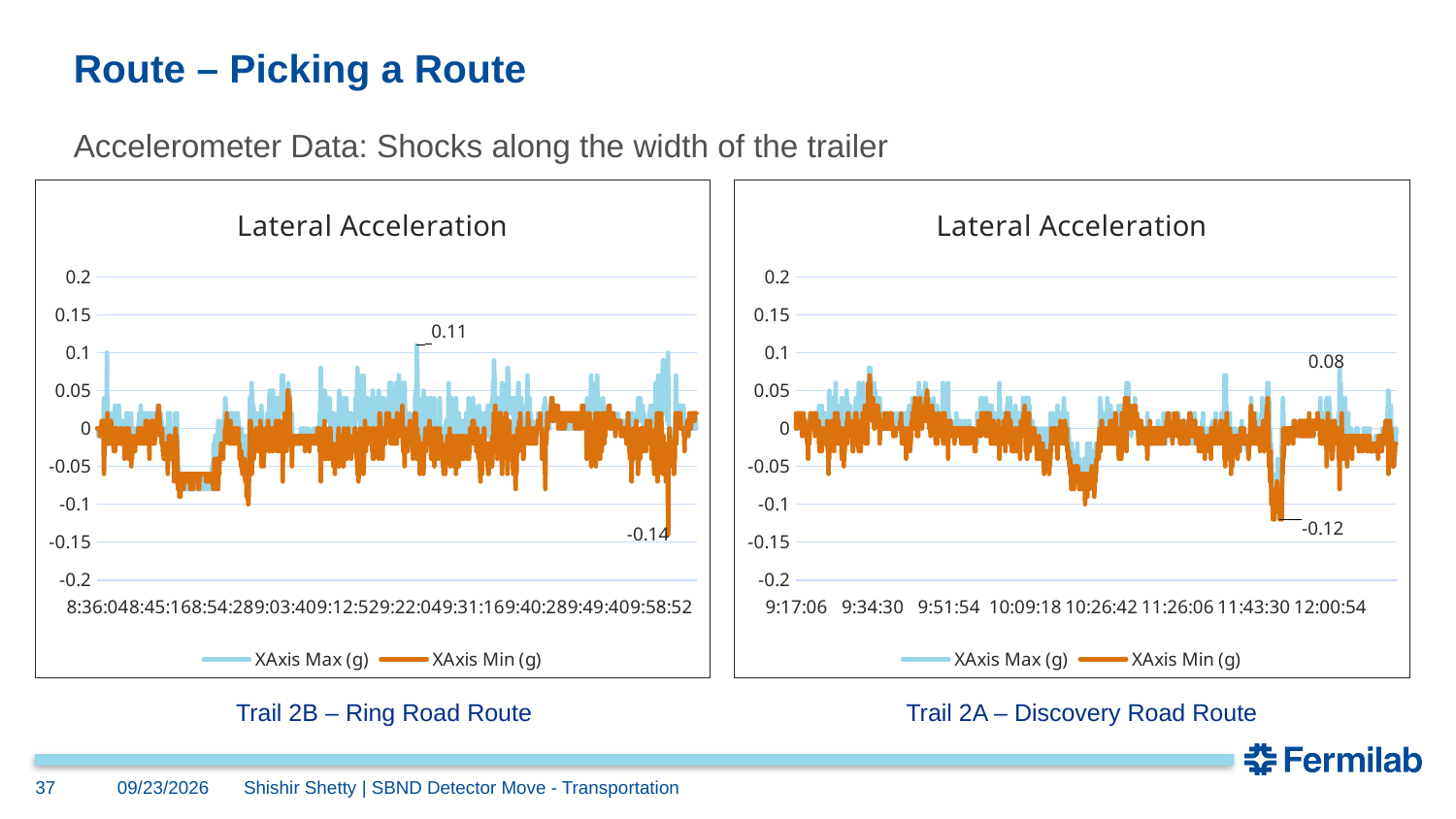
In the right chart (Trail 2A – Discovery Road Route), what is the labelled lowest value of the XAxis Min (g) series? -0.12 In the right chart (Trail 2A – Discovery Road Route), what is the labelled peak value of the XAxis Max (g) series? 0.08 What is the difference between the labelled minimum values of the left chart (-0.14) and the right chart (-0.12)? 0.02 What is the title of both charts on the slide? Lateral Acceleration How many series does the legend of the left chart (Trail 2B – Ring Road Route) list? 2 What kind of chart is the right chart (Trail 2A – Discovery Road Route)? Line chart In the left chart (Trail 2B – Ring Road Route), is the lowest value of the XAxis Min (g) series greater or less than -0.1? less Which route has the larger labelled peak lateral acceleration, Trail 2B – Ring Road Route or Trail 2A – Discovery Road Route? Trail 2B – Ring Road Route What is the difference between the labelled peak values of the left chart (0.11) and the right chart (0.08)? 0.03 In the right chart (Trail 2A – Discovery Road Route), is the highest value of the XAxis Max (g) series greater or less than 0.1? less In the left chart (Trail 2B – Ring Road Route), what is the labelled lowest value of the XAxis Min (g) series? -0.14 In the left chart (Trail 2B – Ring Road Route), what is the labelled peak value of the XAxis Max (g) series? 0.11